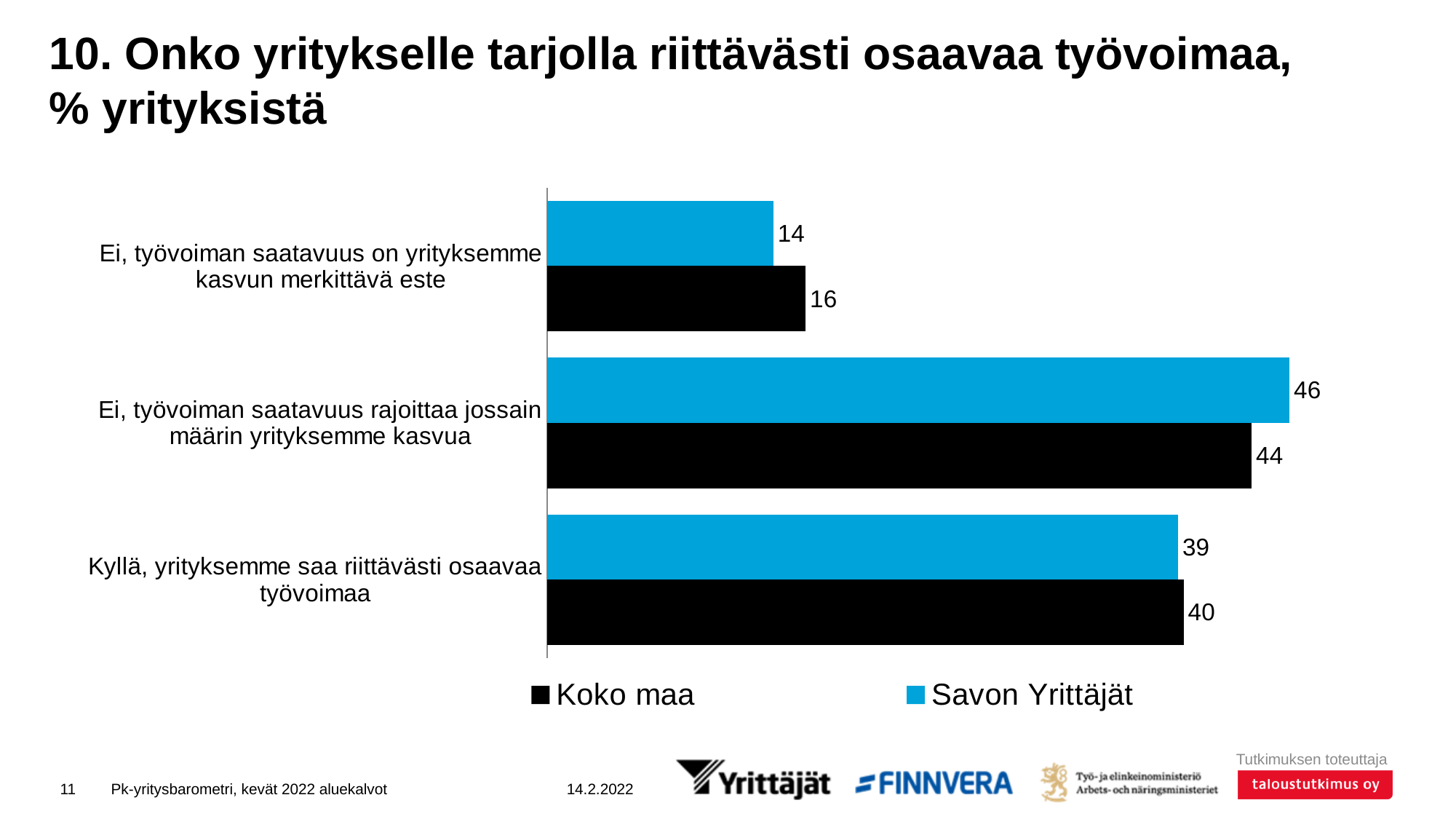
Which colour represents Savon Yrittäjät in the chart? Blue In the category 'Ei, työvoiman saatavuus on yrityksemme kasvun merkittävä este', which series has the larger value, Koko maa or Savon Yrittäjät? Koko maa Which category has the lowest value for Koko maa? Ei, työvoiman saatavuus on yrityksemme kasvun merkittävä este What kind of chart is shown on the slide? Bar chart What is the value for Koko maa in the category 'Ei, työvoiman saatavuus rajoittaa jossain määrin yrityksemme kasvua'? 44 What is the value for Koko maa in the category 'Ei, työvoiman saatavuus on yrityksemme kasvun merkittävä este'? 16 What is the difference between Savon Yrittäjät and Koko maa in the category 'Ei, työvoiman saatavuus rajoittaa jossain määrin yrityksemme kasvua'? 2 What is the difference between Koko maa and Savon Yrittäjät in the category 'Kyllä, yrityksemme saa riittävästi osaavaa työvoimaa'? 1 How many series does the legend list? 2 What is the value for Savon Yrittäjät in the category 'Kyllä, yrityksemme saa riittävästi osaavaa työvoimaa'? 39 Which category has the highest value for Savon Yrittäjät? Ei, työvoiman saatavuus rajoittaa jossain määrin yrityksemme kasvua How many categories are shown on the chart? 3